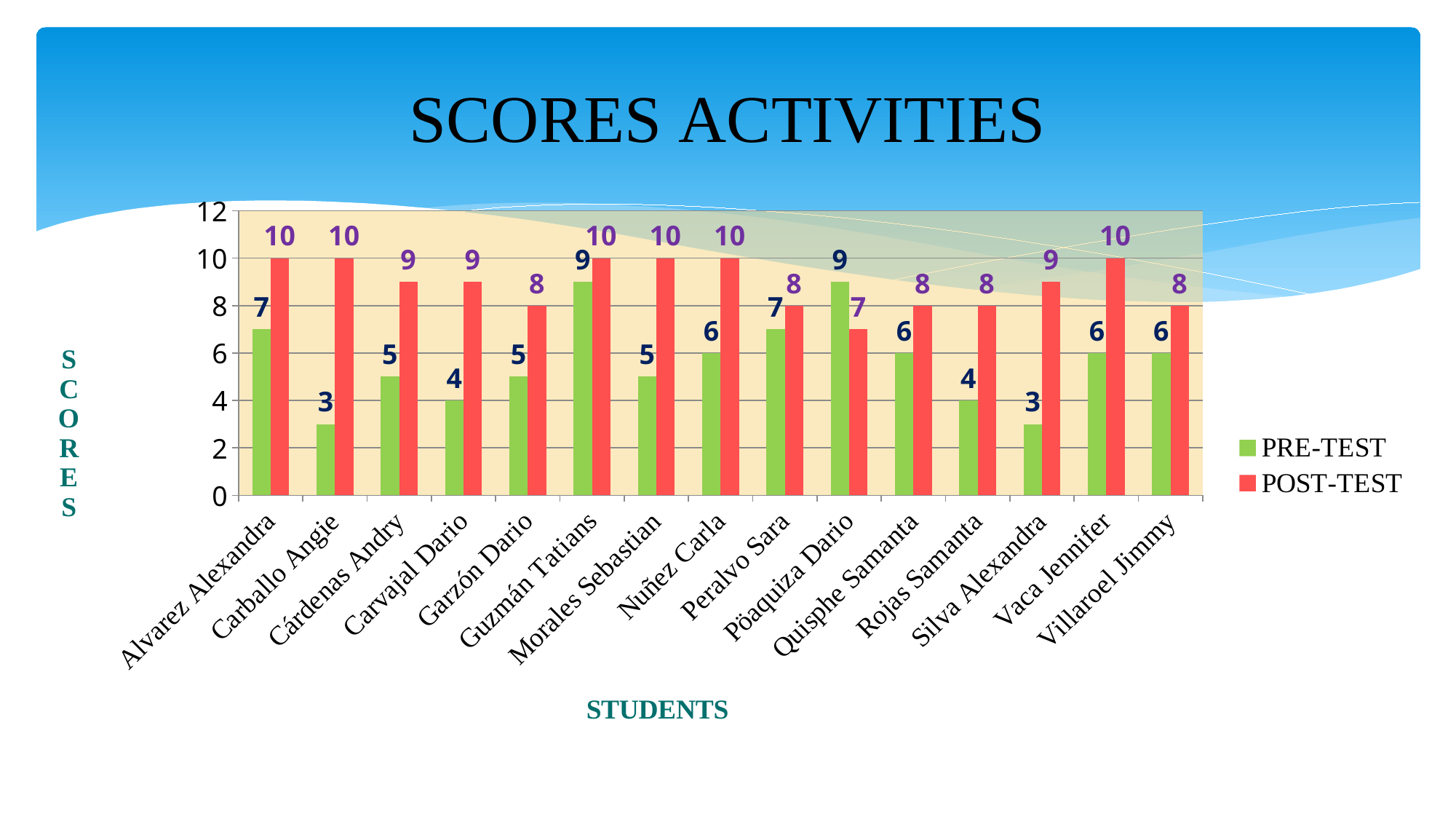
Which student has the lowest POST-TEST score? Pöaquiza Dario What is the PRE-TEST score for Silva Alexandra? 3 What is the difference between Alvarez Alexandra's POST-TEST and PRE-TEST scores? 3 What kind of chart is shown on the slide? bar chart Is the PRE-TEST score for Guzmán Tatians greater or less than 8? greater What is the title of the chart? SCORES ACTIVITIES How many students are shown on the x axis? 15 What is the PRE-TEST score for Carballo Angie? 3 What is the POST-TEST score for Garzón Dario? 8 For Pöaquiza Dario, which is larger, the PRE-TEST or the POST-TEST score? PRE-TEST How much higher is Carballo Angie's POST-TEST score than her PRE-TEST score? 7 How many series does the legend list? 2